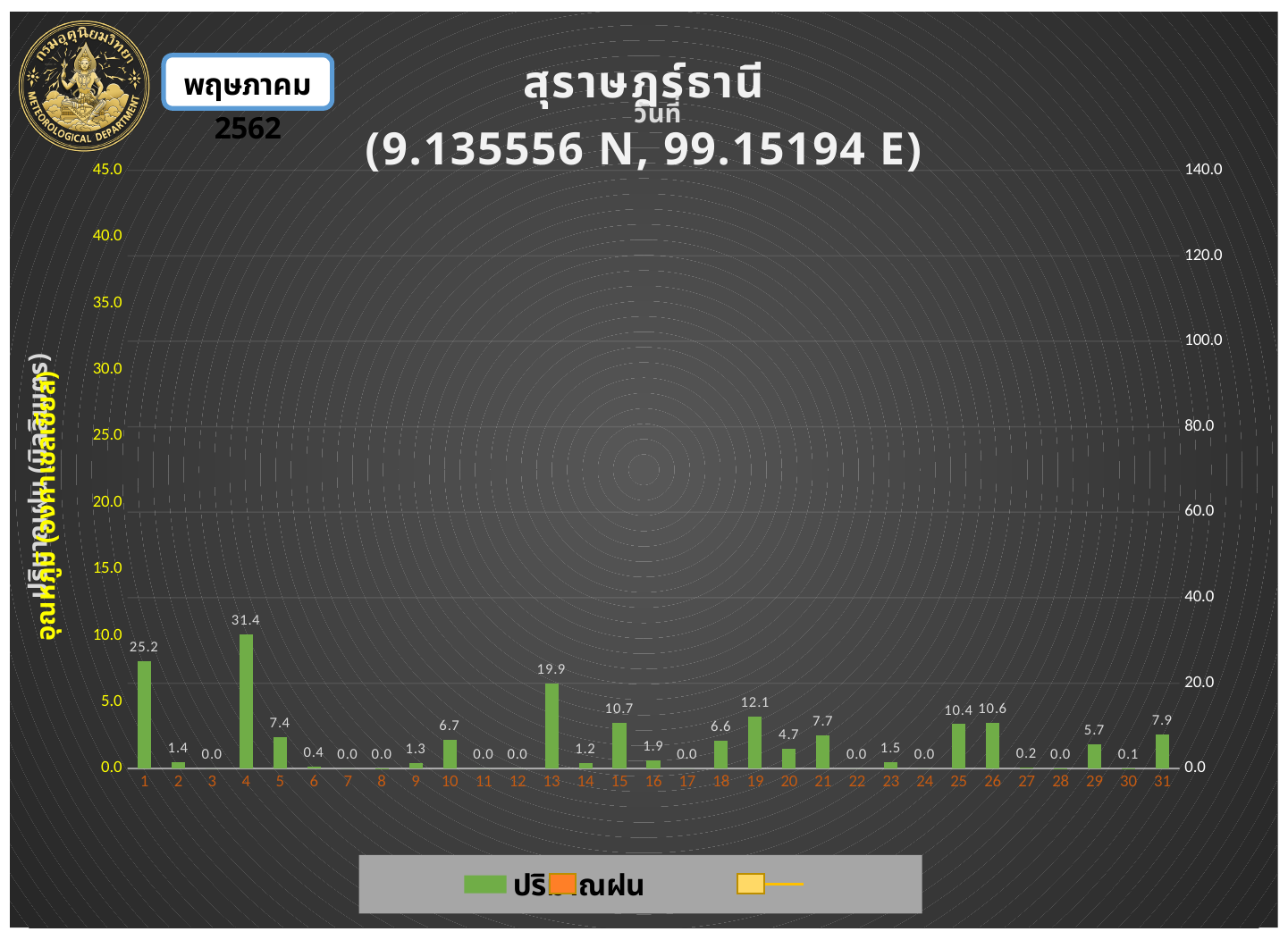
What is the rainfall value shown for day 26? 10.6 What is the rainfall value shown for day 31? 7.9 Which has a larger rainfall value, day 13 or day 19? day 13 What is the rainfall value shown for day 13? 19.9 What is the difference between the rainfall values for day 19 and day 18? 5.5 Which has a larger rainfall value, day 15 or day 21? day 15 Which day has the highest rainfall value? 4 How many days are shown on the x axis? 31 What kind of chart is used to show the rainfall values? bar chart What is the rainfall value shown for day 4? 31.4 What coordinates are given in the chart title? 9.135556 N, 99.15194 E What is the difference between the rainfall values for day 4 and day 1? 6.2